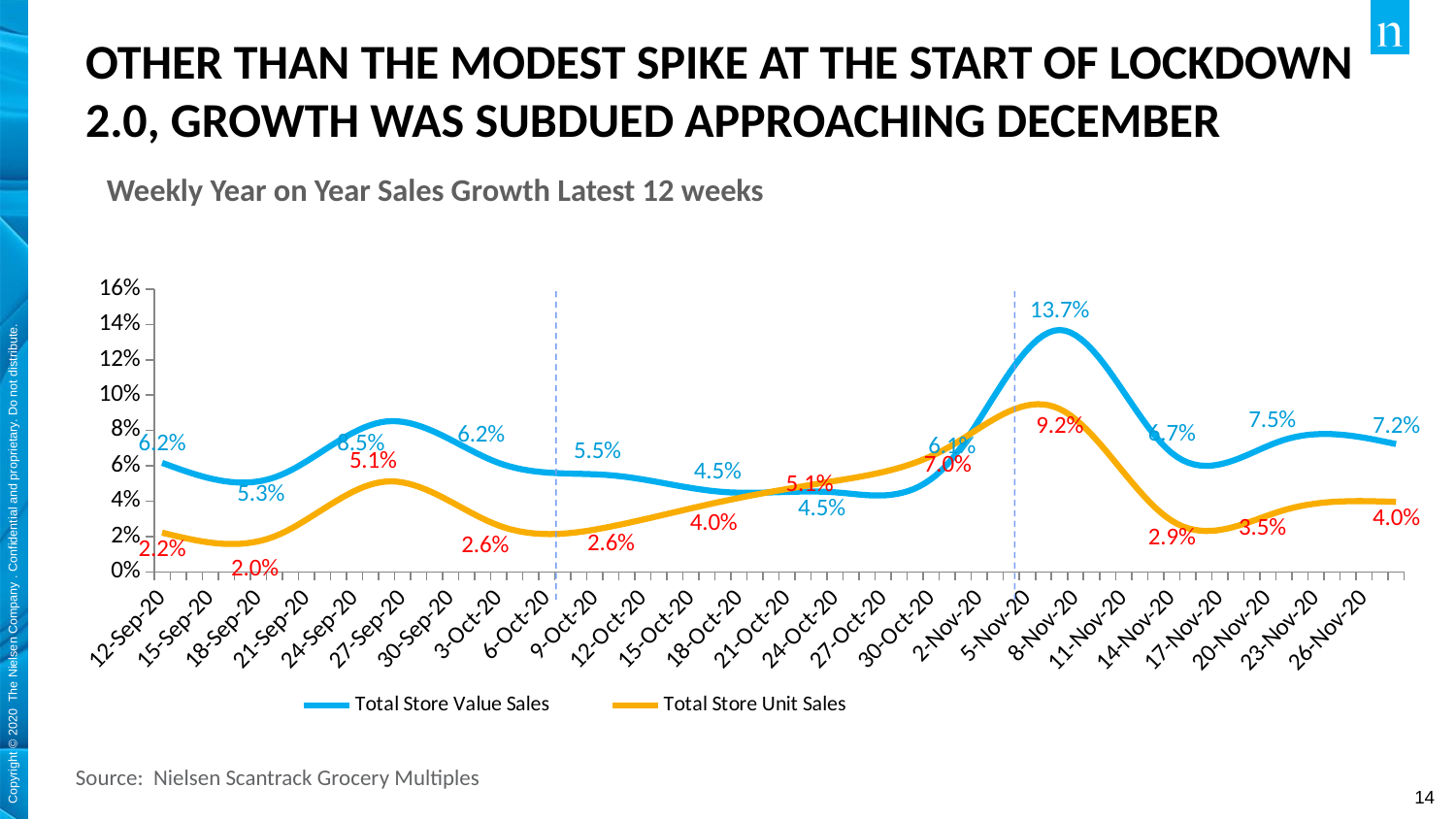
What is the subtitle of the chart? Weekly Year on Year Sales Growth Latest 12 weeks What is the Total Store Value Sales growth at the first point, 12-Sep-20? 6.2% How many series does the legend list? 2 What is the highest labelled value for Total Store Value Sales? 13.7% What is the highest labelled value for Total Store Unit Sales? 9.2% What is the lowest labelled value for Total Store Value Sales? 4.5% What is the lowest labelled value for Total Store Unit Sales? 2.0% At the last labelled point, which series is higher: Total Store Value Sales (7.2%) or Total Store Unit Sales (4.0%)? Total Store Value Sales What is the difference between the peak Total Store Value Sales value (13.7%) and the peak Total Store Unit Sales value (9.2%)? 4.5 percentage points What kind of chart is shown on the slide? Line chart How many labelled data points does each series have? 12 What is the Total Store Unit Sales growth at the last labelled point on the right of the chart? 4.0%